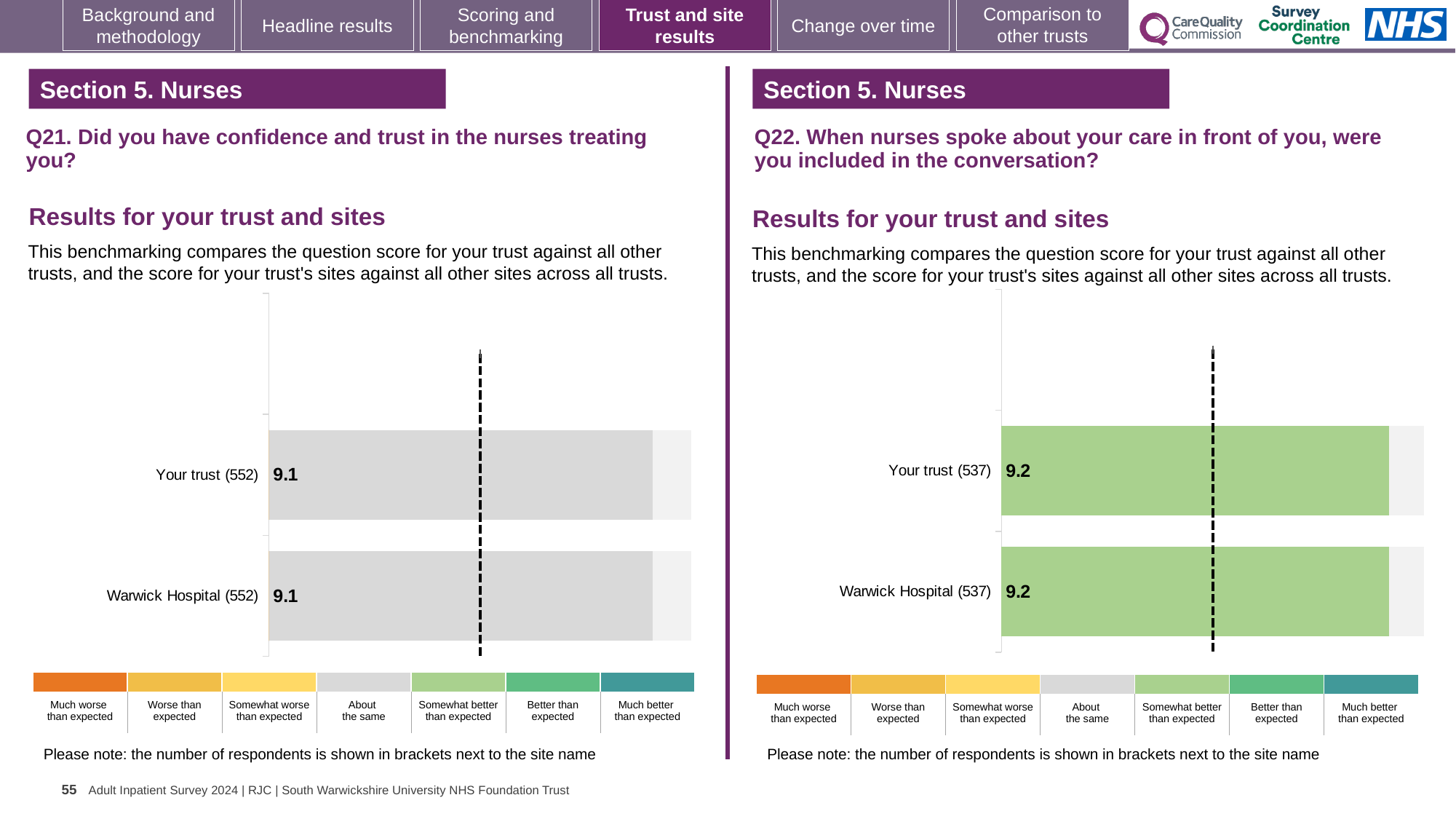
In the Q22 chart on the right, what is the score for Warwick Hospital (537)? 9.2 In the Q22 chart on the right, what is the score for Your trust (537)? 9.2 What kind of chart is the Q21 chart on the left? Bar chart In the Q21 chart on the left, what is the score for Your trust (552)? 9.1 How many bars are plotted in the Q22 chart on the right? 2 In the Q22 chart on the right, what is the difference between the score for Your trust and the score for Warwick Hospital? 0 In the Q21 chart on the left, what is the score for Warwick Hospital (552)? 9.1 In the Q21 chart on the left, how many respondents are shown in brackets for Warwick Hospital? 552 In the Q22 chart on the right, which benchmark category does the green colour of the bars correspond to in the legend? Somewhat better than expected In the Q21 chart on the left, which benchmark category does the grey colour of the bars correspond to in the legend? About the same In the Q21 chart on the left, what is the difference between the score for Your trust and the score for Warwick Hospital? 0 How many bars are plotted in the Q21 chart on the left? 2